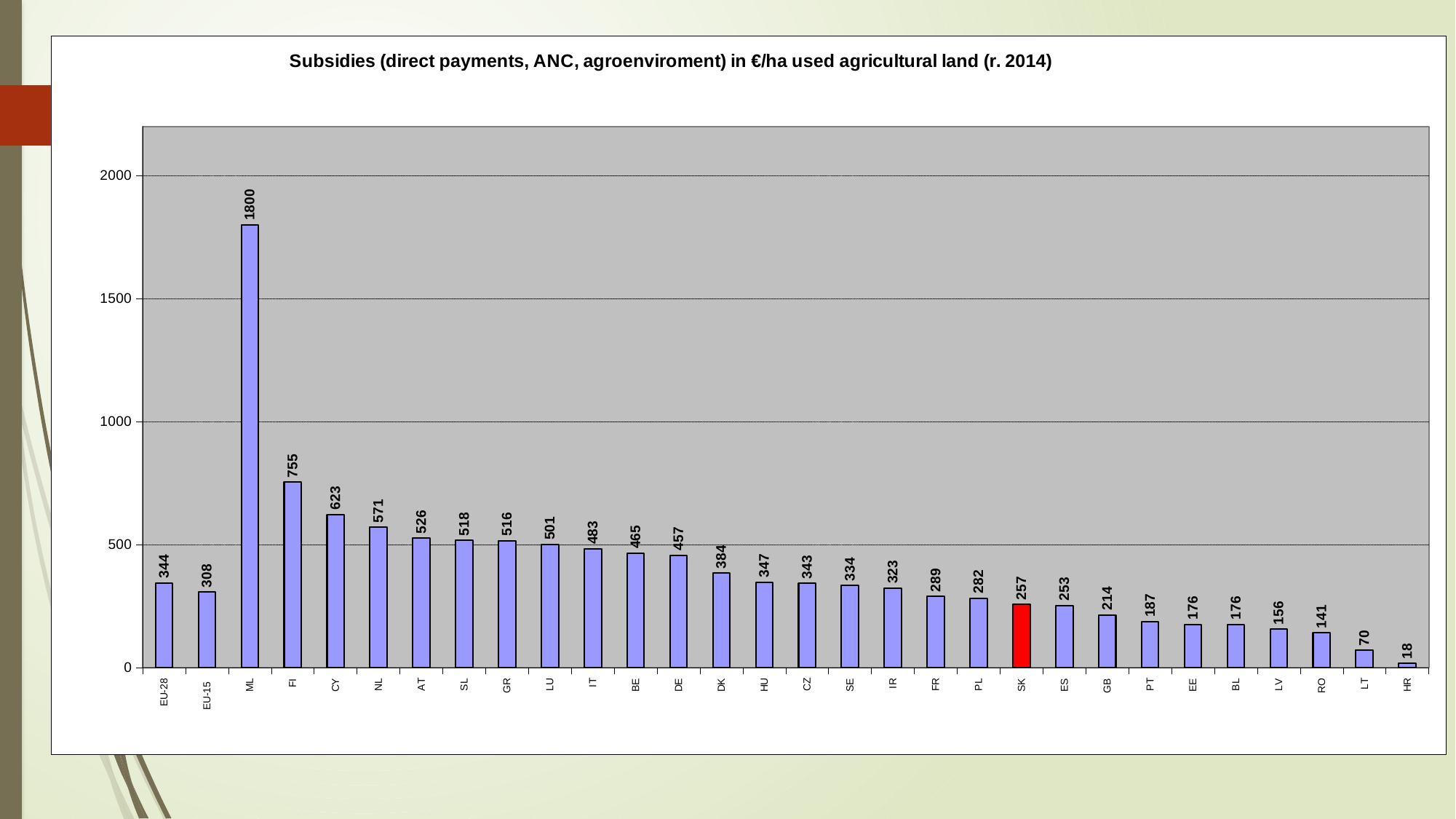
What is the difference between the values for EU-28 and EU-15? 36 What is the value for ML? 1800 What kind of chart is this? bar chart Which category has the highest value? ML What is the difference between the values for FI and CY? 132 What is the value for EU-28? 344 Which bar is coloured red? SK Is the value for NL greater or less than 500? greater How many categories are shown on the x axis? 30 What is the value for SK? 257 Which is larger, the value for DK or the value for HU? DK Which category has the lowest value? HR